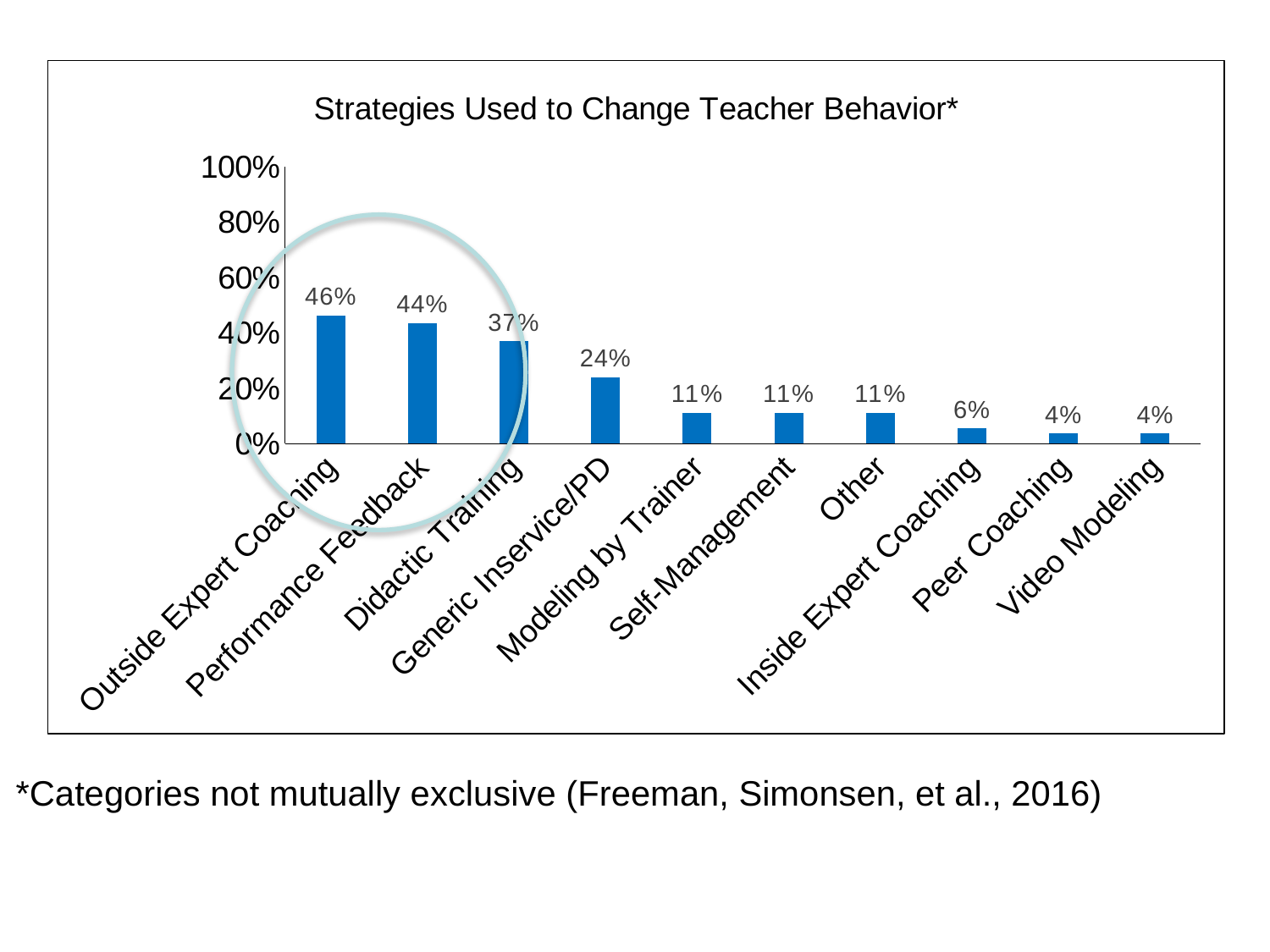
Which is larger, Performance Feedback or Didactic Training? Performance Feedback What is the value for Inside Expert Coaching? 6% What is the value for Outside Expert Coaching? 46% What is the value for Generic Inservice/PD? 24% What is the difference between Outside Expert Coaching and Performance Feedback? 2% Do the values generally rise or fall from left to right along the x axis? fall Which category has the highest value? Outside Expert Coaching What is the title of the chart? Strategies Used to Change Teacher Behavior* What kind of chart is this? bar chart Is the value for Generic Inservice/PD greater or less than 20%? greater What is the difference between Didactic Training and Generic Inservice/PD? 13% How many categories are shown on the x axis? 10